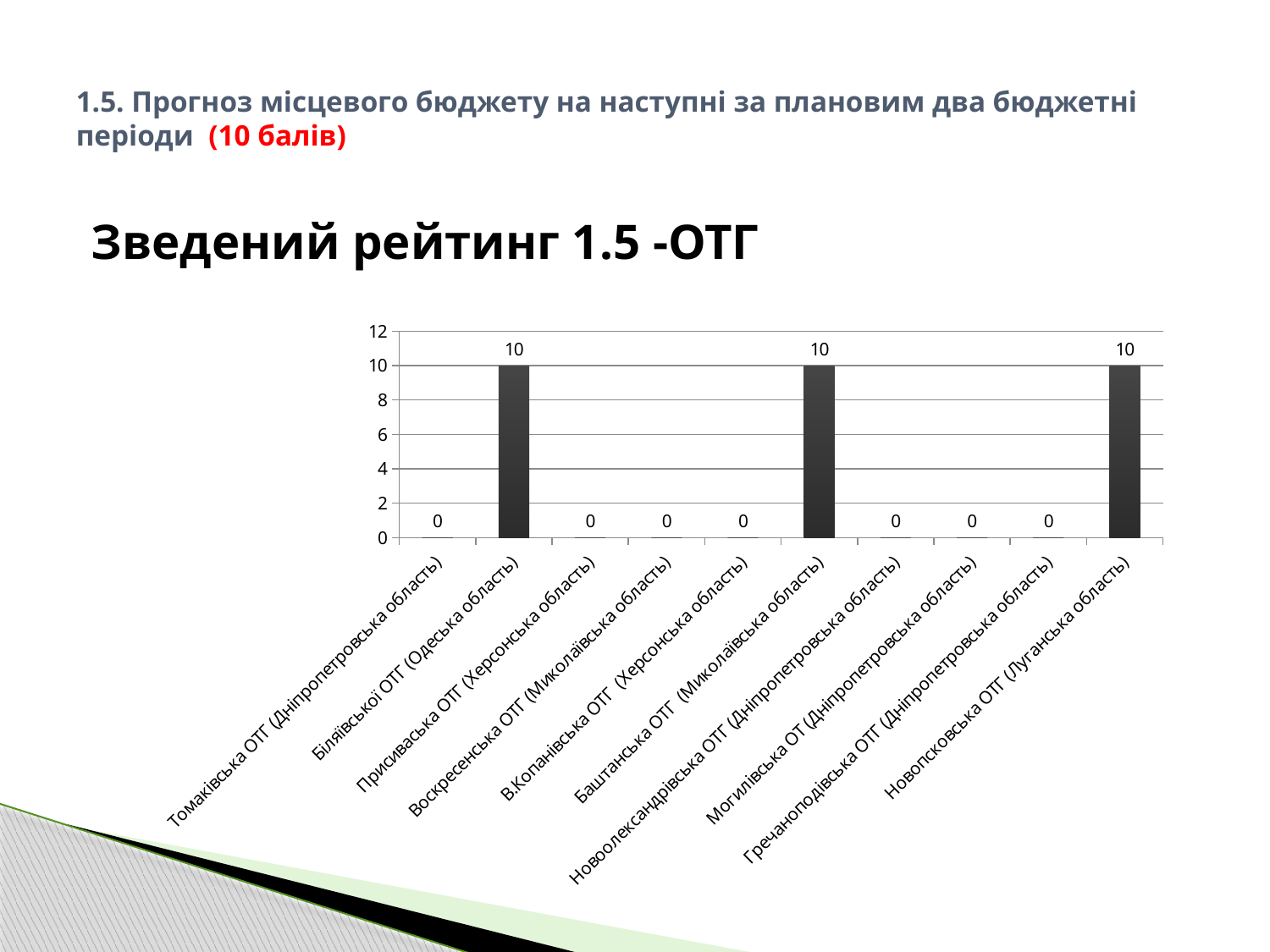
Which is larger, the value for Присиваська ОТГ (Херсонська область) or the value for Новопсковська ОТГ (Луганська область)? Новопсковська ОТГ (Луганська область) What is the value for Томаківська ОТГ (Дніпропетровська область)? 0 What is the value for Баштанська ОТГ (Миколаївська область)? 10 How many categories have a value of 10 in the chart? 3 What is the difference between the values for Баштанська ОТГ (Миколаївська область) and Воскресенська ОТГ (Миколаївська область)? 10 What is the maximum value shown on the y axis of the chart? 12 What is the value for Біляївської ОТГ (Одеська область)? 10 How many categories (ОТГ) are shown on the x axis of the chart? 10 What is the value for Могилівська ОТ (Дніпропетровська область)? 0 What is the value for Новопсковська ОТГ (Луганська область)? 10 What is the title of the chart section on the slide? Зведений рейтинг 1.5 -ОТГ What type of chart is shown on the slide? bar chart